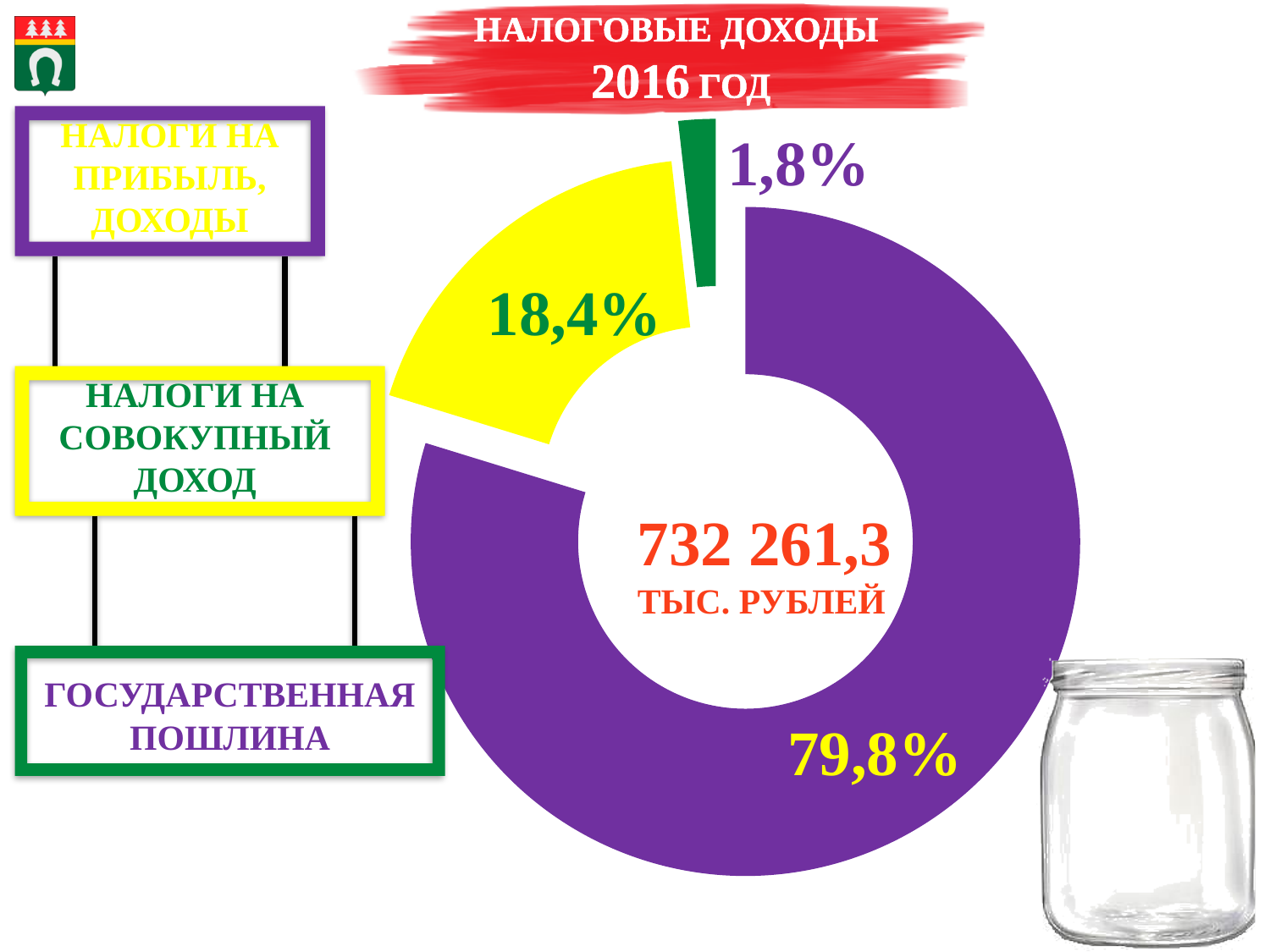
What kind of chart is shown on the slide? Pie (donut) chart What year does the chart title refer to? 2016 Which category has the smallest share of tax revenues? ГОСУДАРСТВЕННАЯ ПОШЛИНА What share of tax revenues does the purple slice (НАЛОГИ НА ПРИБЫЛЬ, ДОХОДЫ) represent? 79,8% Which is larger: the share for НАЛОГИ НА СОВОКУПНЫЙ ДОХОД or the share for ГОСУДАРСТВЕННАЯ ПОШЛИНА? НАЛОГИ НА СОВОКУПНЫЙ ДОХОД What total amount is shown in the centre of the chart? 732 261,3 тыс. рублей What is the difference in percentage points between the purple slice (79,8%) and the yellow slice (18,4%)? 61,4 What share of tax revenues does the yellow slice (НАЛОГИ НА СОВОКУПНЫЙ ДОХОД) represent? 18,4% Which category has the largest share of tax revenues? НАЛОГИ НА ПРИБЫЛЬ, ДОХОДЫ What share of tax revenues does the green slice (ГОСУДАРСТВЕННАЯ ПОШЛИНА) represent? 1,8% How many slices does the chart have? 3 What is the difference in percentage points between the yellow slice (18,4%) and the green slice (1,8%)? 16,6